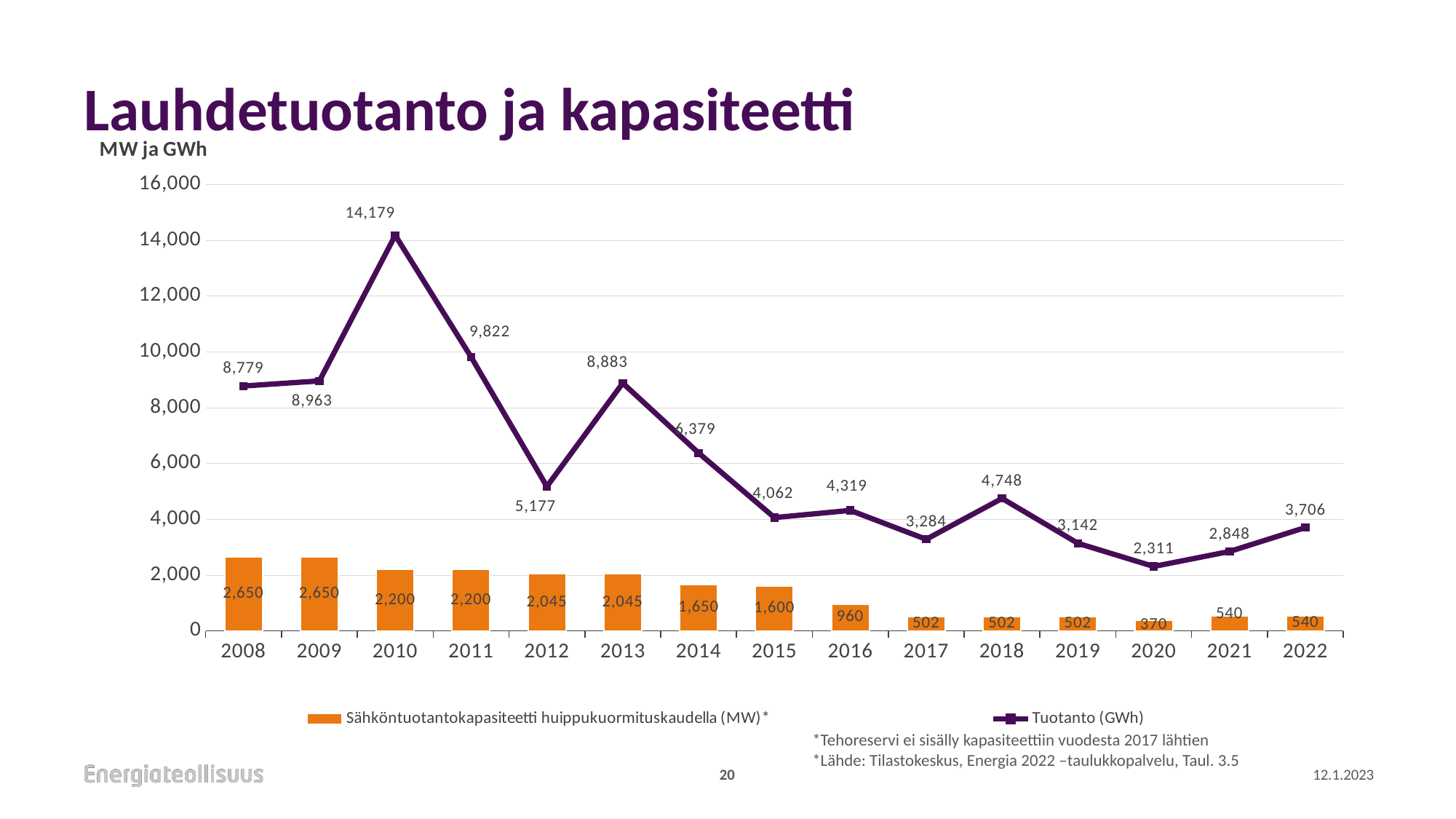
What is the difference between Tuotanto (GWh) in 2010 and in 2011? 4,357 What is the Sähköntuotantokapasiteetti huippukuormituskaudella (MW) value for 2016? 960 In which year is Tuotanto (GWh) lowest? 2020 In which year is the Sähköntuotantokapasiteetti huippukuormituskaudella (MW) bar lowest? 2020 How many series does the legend list? 2 Which year has the larger Tuotanto (GWh) value, 2013 or 2014? 2013 In which year is Tuotanto (GWh) highest? 2010 What is the difference between the capacity (MW) in 2008 and in 2022? 2,110 Is the Tuotanto (GWh) value for 2012 greater or less than 6,000? less What kind of chart is shown on the slide? Combination bar and line chart How many years are shown on the x axis of the chart? 15 What is the Tuotanto (GWh) value for 2010? 14,179